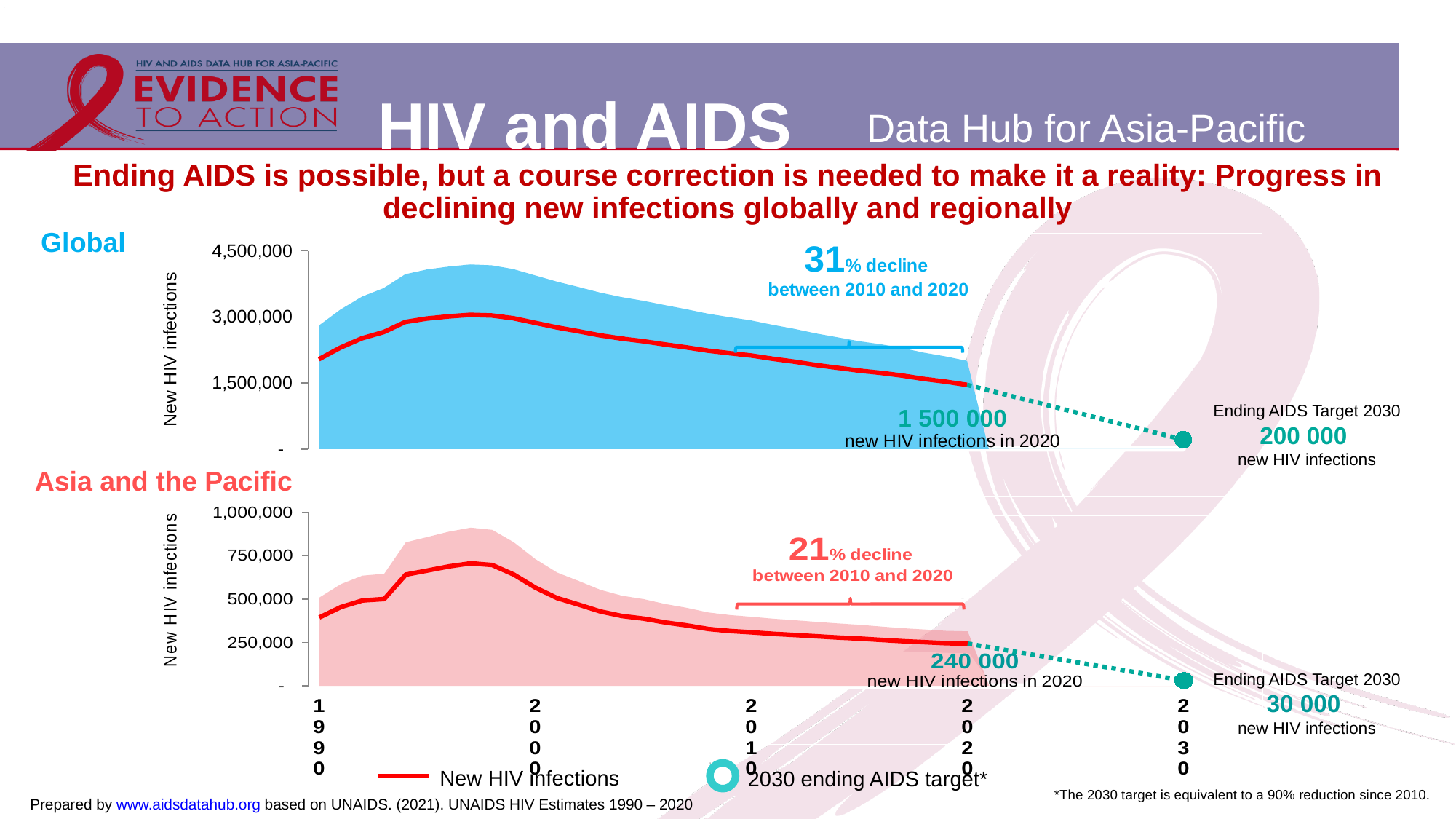
On the Global chart, how many new HIV infections were there in 2020? 1 500 000 On the Global chart, what percentage decline in new HIV infections is shown between 2010 and 2020? 31% What kind of chart is used for the Global and Asia and the Pacific panels? combination area and line chart How many entries does the legend at the bottom of the slide list? 2 On the Global chart, is the value for new HIV infections in 1990 greater or less than 3,000,000? less On the Global chart, what is the difference between new HIV infections in 2020 and the Ending AIDS Target 2030? 1 300 000 On the Asia and the Pacific chart, what percentage decline in new HIV infections is shown between 2010 and 2020? 21% On the Asia and the Pacific chart, what is the Ending AIDS Target 2030 for new HIV infections? 30 000 On the Asia and the Pacific chart, how many new HIV infections were there in 2020? 240 000 On the Global chart, what is the Ending AIDS Target 2030 for new HIV infections? 200 000 On the Global chart, do new HIV infections rise or fall between 2010 and 2020? fall On the Asia and the Pacific chart, is the peak value of the new HIV infections line greater or less than 500,000? greater